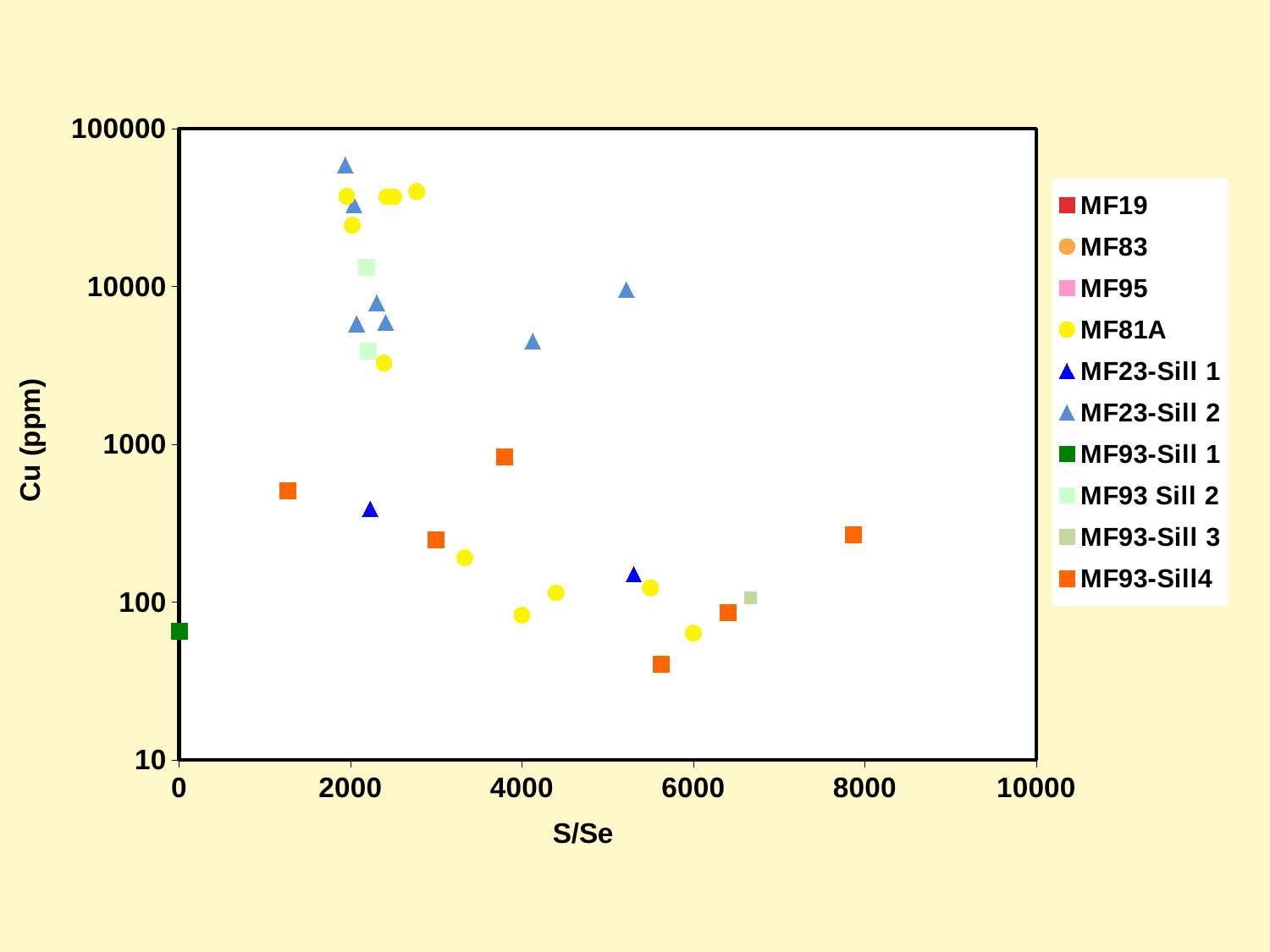
Which series contains the point with the lowest Cu (ppm) value? MF93-Sill4 How many points are plotted for MF23-Sill 1? 2 How many points are plotted for MF93-Sill4? 6 Is the Cu (ppm) value for the MF93-Sill 1 point greater or less than 100? less What kind of chart is shown on the slide? scatter chart Which series has the point with the largest S/Se value? MF93-Sill4 How many series does the legend list? 10 Which series contains the point with the highest Cu (ppm) value? MF23-Sill 2 Is the highest Cu (ppm) value for MF23-Sill 2 greater or less than 10000? greater Is the Cu (ppm) value of the MF93-Sill4 point near S/Se 8000 greater or less than 1000? less What is the title of the y axis? Cu (ppm) What is the title of the x axis? S/Se